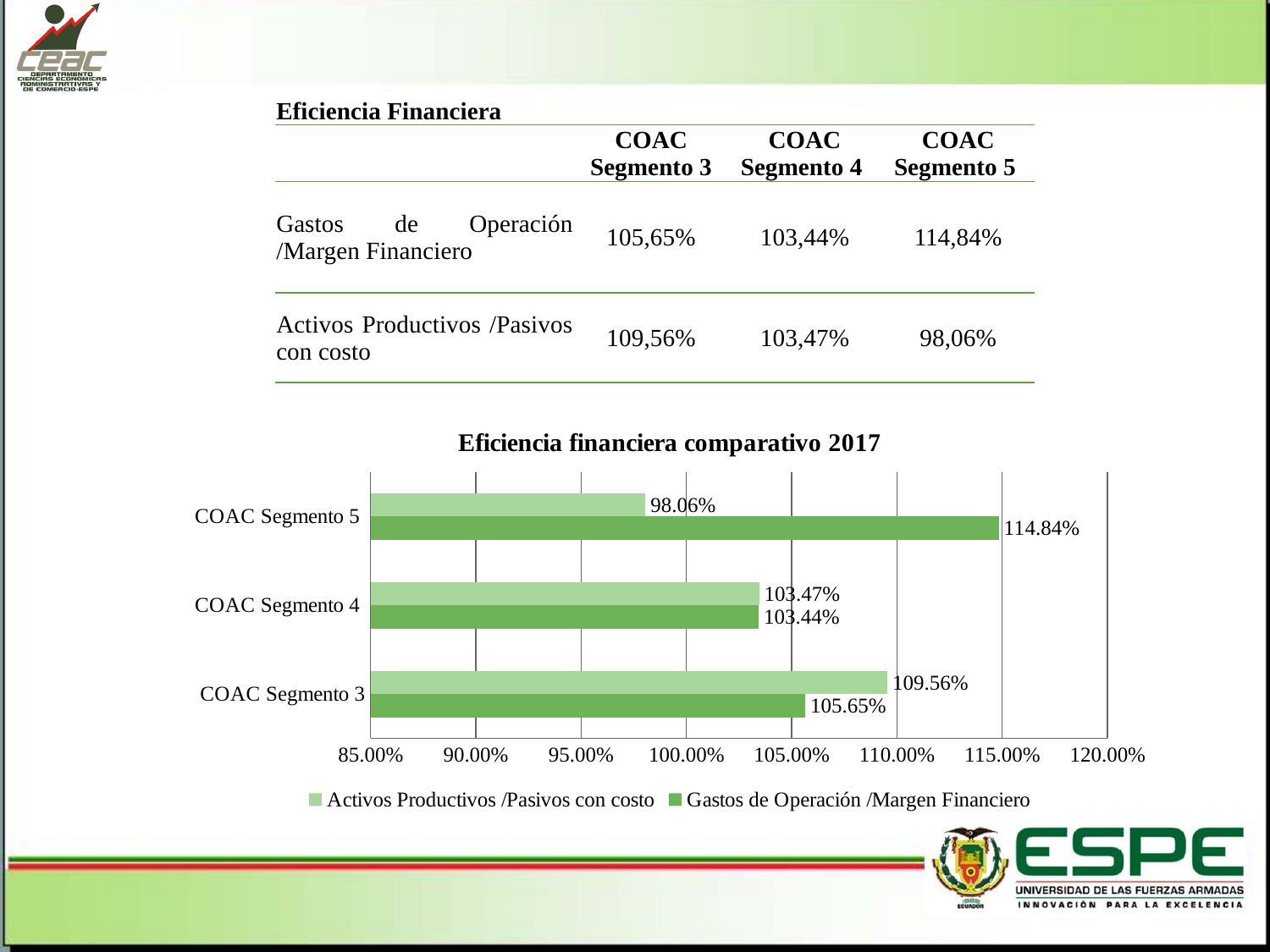
Which segment has the highest value for Activos Productivos /Pasivos con costo? COAC Segmento 3 What is the difference between Gastos de Operación /Margen Financiero and Activos Productivos /Pasivos con costo for COAC Segmento 5? 16.78% Which segment has the highest value for Gastos de Operación /Margen Financiero? COAC Segmento 5 What is the value of Gastos de Operación /Margen Financiero for COAC Segmento 3? 105.65% What is the value of Activos Productivos /Pasivos con costo for COAC Segmento 4? 103.47% Is the value of Activos Productivos /Pasivos con costo for COAC Segmento 5 greater or less than 100.00%? less For COAC Segmento 3, which is larger: Activos Productivos /Pasivos con costo or Gastos de Operación /Margen Financiero? Activos Productivos /Pasivos con costo How many series does the legend list? 2 Which segment has the lowest value for Activos Productivos /Pasivos con costo? COAC Segmento 5 How many segments are shown on the chart? 3 What is the value of Activos Productivos /Pasivos con costo for COAC Segmento 5? 98.06% What type of chart is shown on the slide? Bar chart